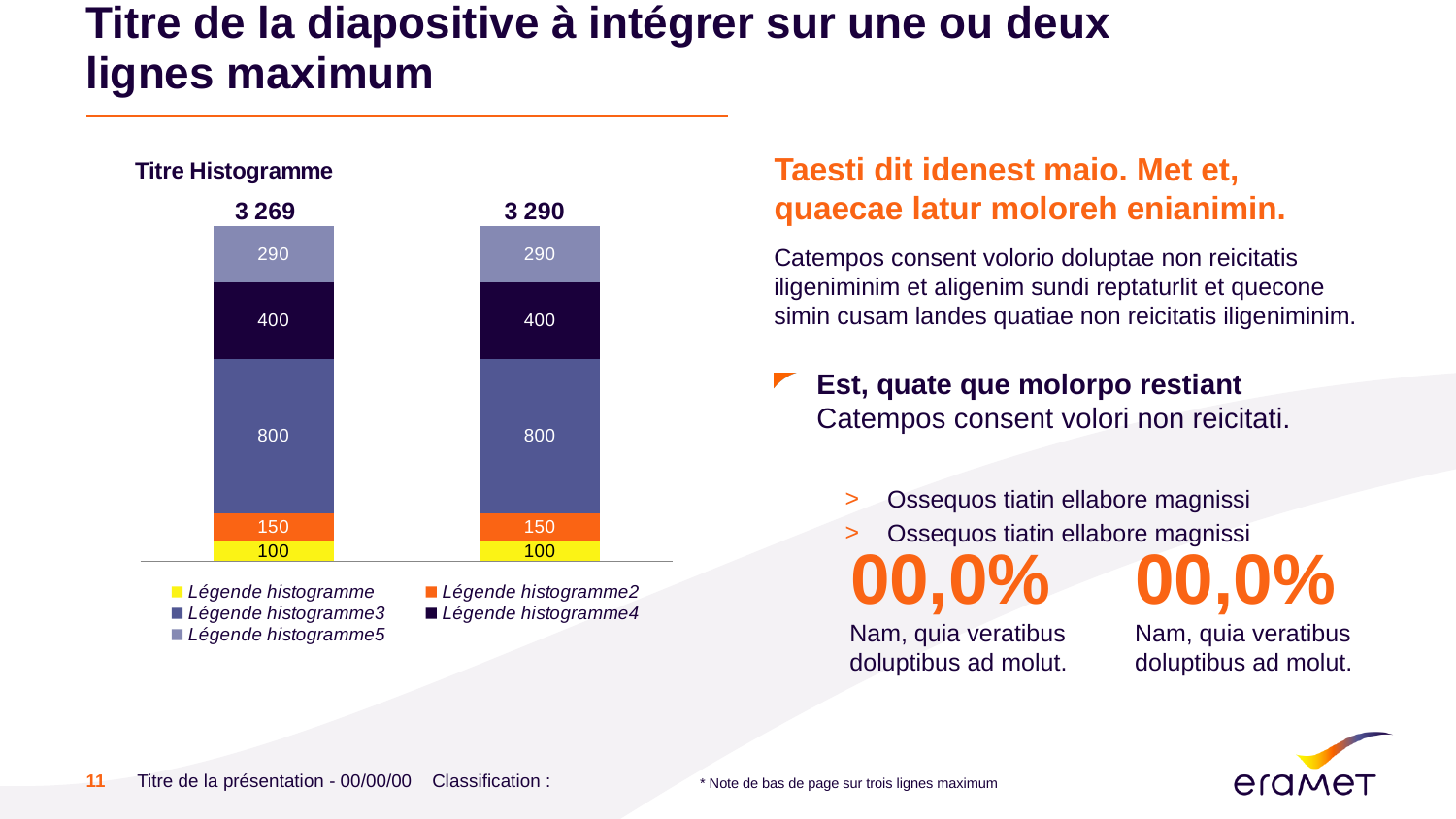
What kind of chart is shown on the slide? stacked bar chart How many series does the chart legend list? 5 What is the title of the chart? Titre Histogramme Which bar has the larger printed total, the left bar or the right bar? the right bar What is the value of the Légende histogramme5 segment in the right bar? 290 What is the value of the Légende histogramme3 segment in the left bar? 800 How many bars does the chart show? 2 What is the difference between the printed totals of the right bar and the left bar? 21 What is the value of the Légende histogramme2 segment in the left bar? 150 Which series has the largest segment in the left bar? Légende histogramme3 What total value is printed above the left bar? 3 269 What total value is printed above the right bar? 3 290